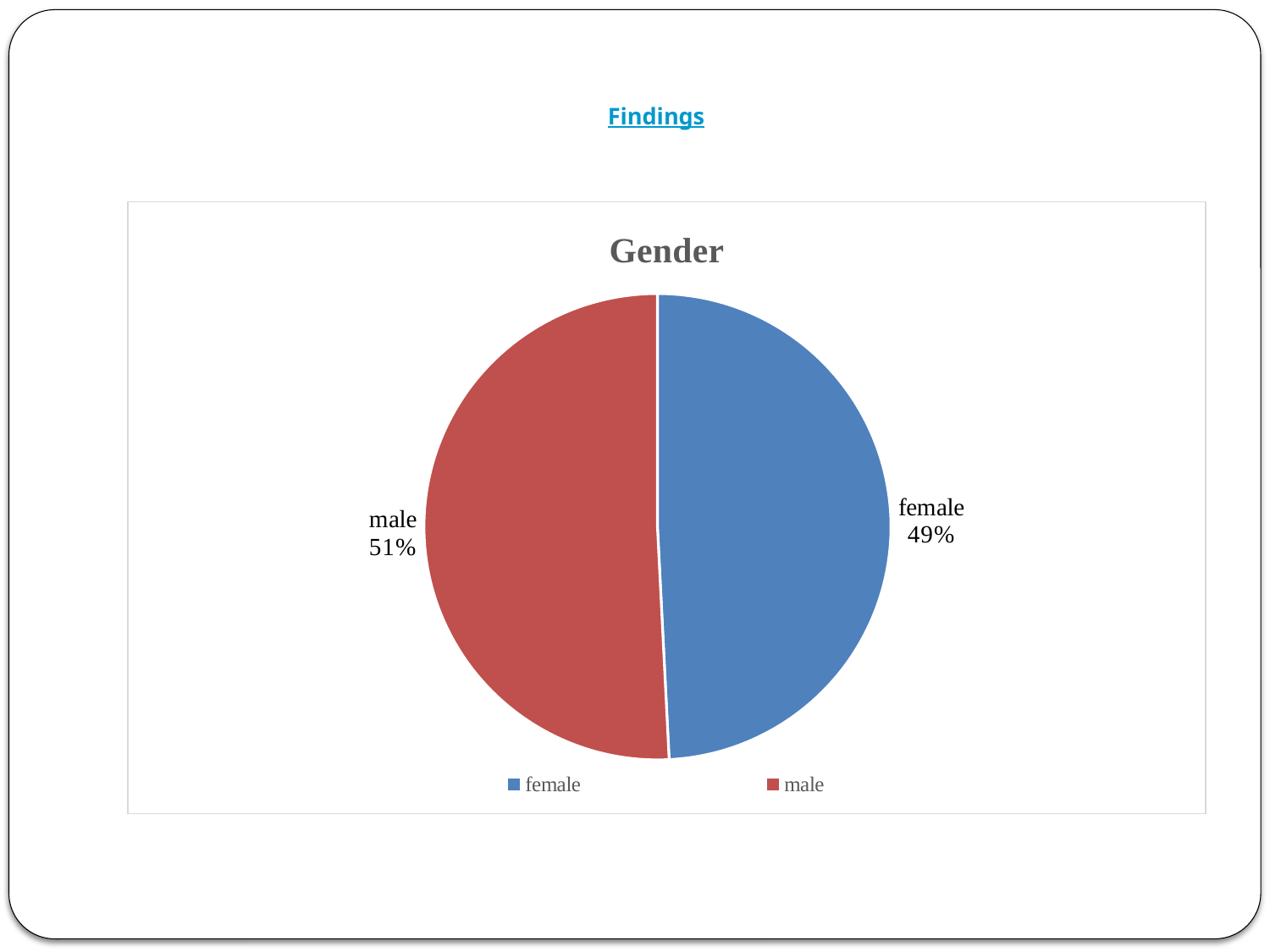
How many entries does the legend list? 2 Is the male share greater or less than 50%? greater What share of the pie is labelled female? 49% Which is larger, the male share or the female share? male How many slices does the pie chart have? 2 What colour is the female slice in the pie chart? blue What kind of chart is shown on the slide? pie chart What share of the pie is labelled male? 51% What is the title of the chart? Gender Which slice of the pie is the smallest? female What is the difference in percentage points between the male and female shares? 2% Which slice of the pie is the largest? male